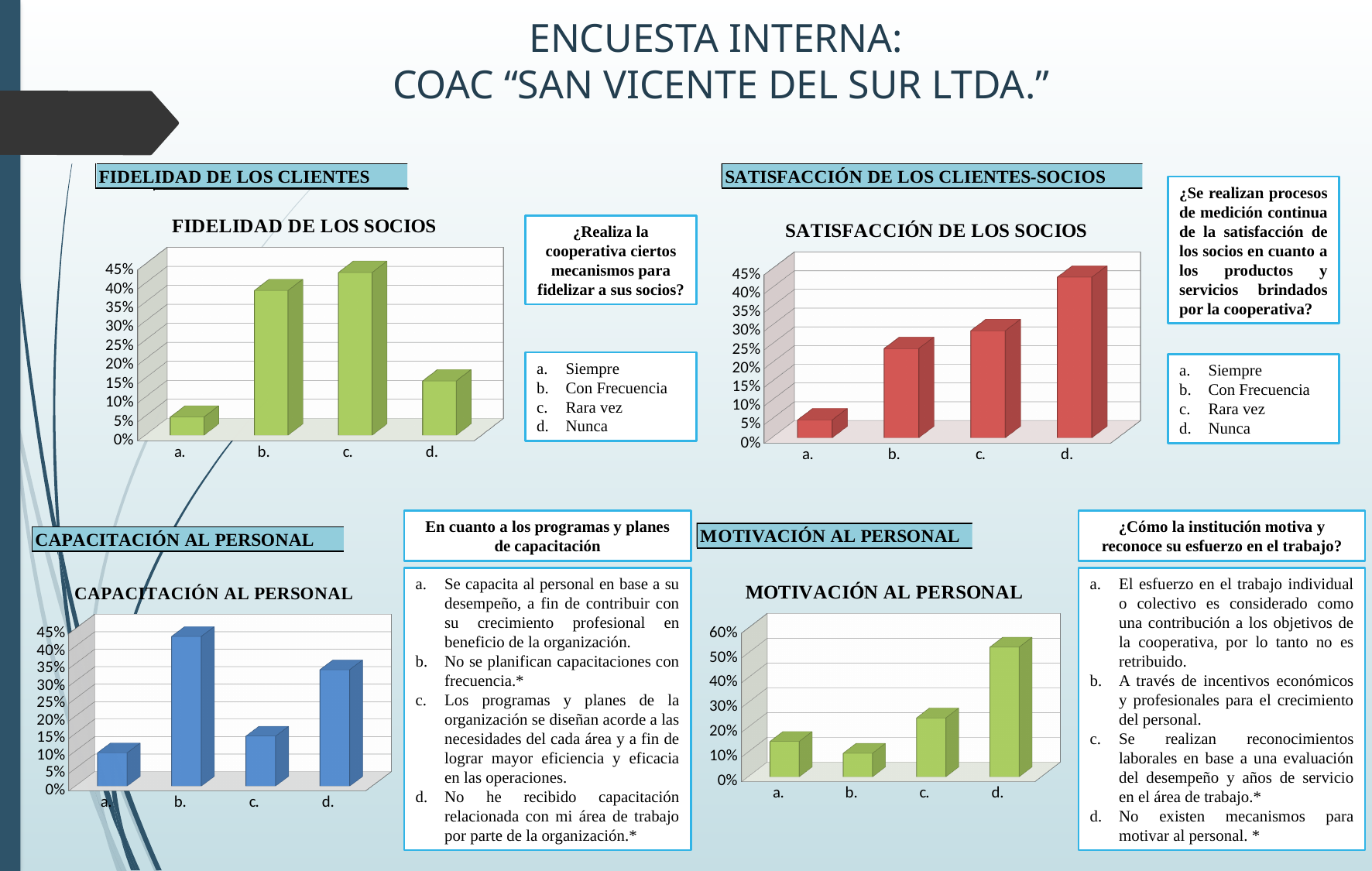
In the FIDELIDAD DE LOS SOCIOS chart, which category has the lowest value? a. In the SATISFACCIÓN DE LOS SOCIOS chart, which category has the lowest value? a. How many categories are shown on the x axis of the MOTIVACIÓN AL PERSONAL chart? 4 What kind of chart is the CAPACITACIÓN AL PERSONAL chart? Bar chart In the MOTIVACIÓN AL PERSONAL chart, is the value for d. greater or less than 40%? greater In the CAPACITACIÓN AL PERSONAL chart, which category has the highest value? b. In the MOTIVACIÓN AL PERSONAL chart, which category has the lowest value? b. In the FIDELIDAD DE LOS SOCIOS chart, which category has the highest value? c. In the SATISFACCIÓN DE LOS SOCIOS chart, which category has the highest value? d. In the CAPACITACIÓN AL PERSONAL chart, which is larger, the value for b. or the value for d.? b. In the SATISFACCIÓN DE LOS SOCIOS chart, is the value for a. greater or less than 10%? less In the FIDELIDAD DE LOS SOCIOS chart, is the value for b. greater or less than 30%? greater